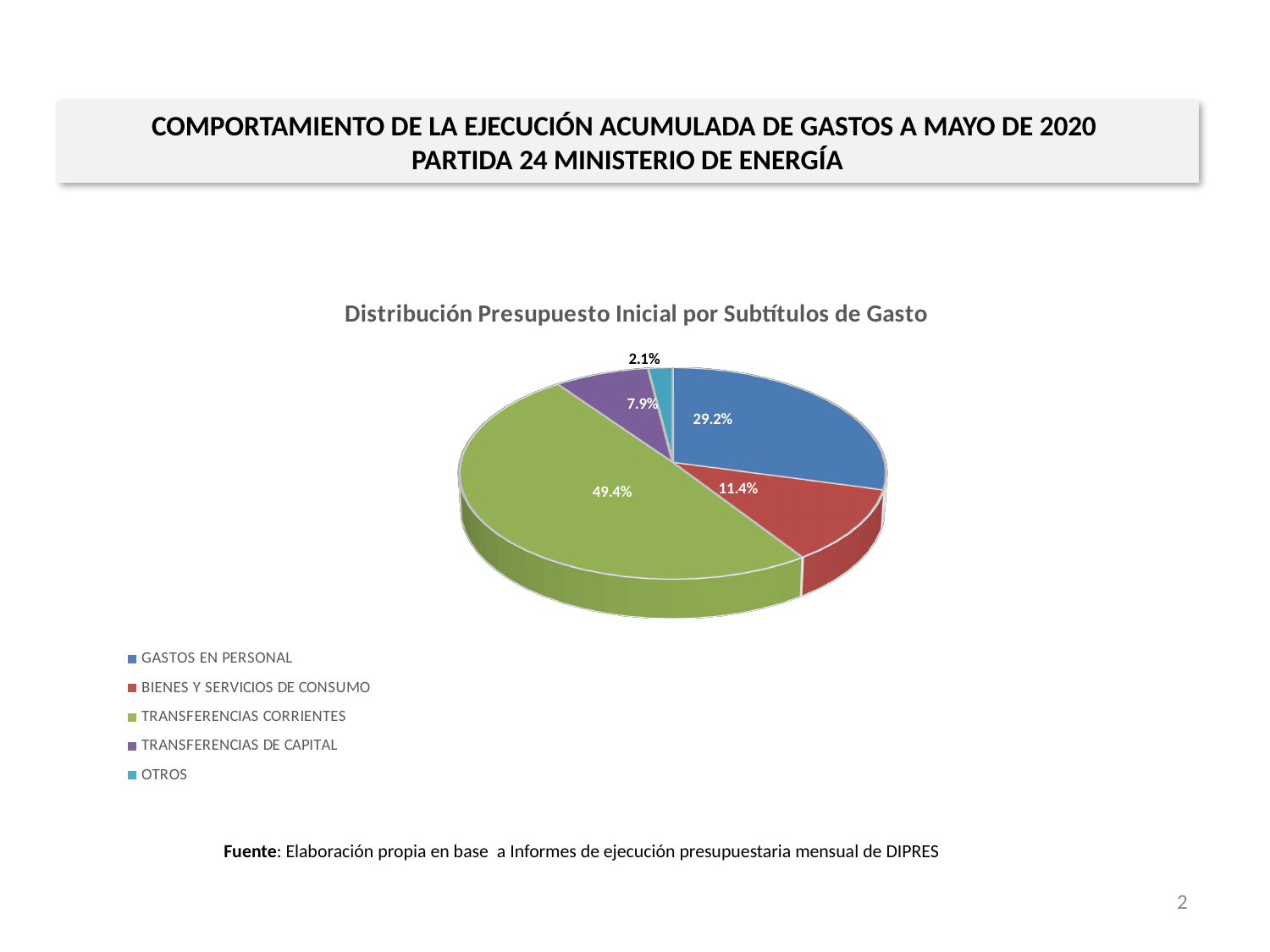
What is the value shown for GASTOS EN PERSONAL? 29.2% What is the value shown for OTROS? 2.1% Which category has the largest slice of the pie? TRANSFERENCIAS CORRIENTES What is the value shown for TRANSFERENCIAS DE CAPITAL? 7.9% What is the value shown for BIENES Y SERVICIOS DE CONSUMO? 11.4% What is the difference between the shares of TRANSFERENCIAS CORRIENTES and GASTOS EN PERSONAL? 20.2% What kind of chart is shown on the slide? Pie chart How many categories does the pie chart show? 5 Which is larger, the share for BIENES Y SERVICIOS DE CONSUMO or the share for TRANSFERENCIAS DE CAPITAL? BIENES Y SERVICIOS DE CONSUMO What is the title of the chart? Distribución Presupuesto Inicial por Subtítulos de Gasto Which category has the smallest slice of the pie? OTROS What share of the pie does TRANSFERENCIAS CORRIENTES represent? 49.4%